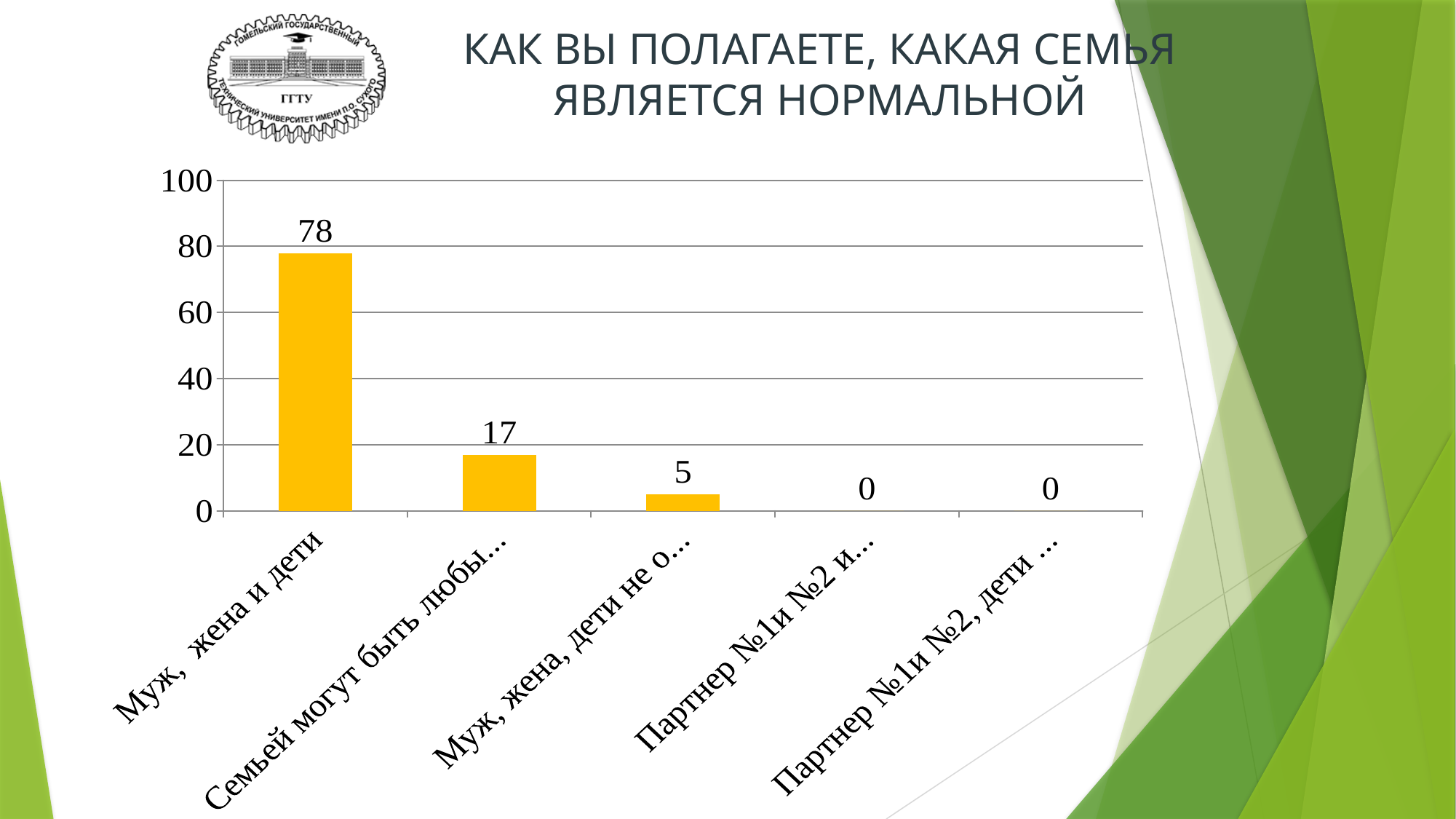
What value is shown for the category "Муж, жена и дети"? 78 What value is shown for the second bar from the left (the category beginning "Семьей могут быть любы...")? 17 What is the difference between the value for "Муж, жена и дети" and the value for the second bar from the left? 61 Which is larger: the value for "Муж, жена и дети" or the value for the third bar from the left? Муж, жена и дети What kind of chart is shown on the slide? bar chart What value is shown for the fourth category from the left (beginning "Партнер №1и №2 и...")? 0 Is the value for "Муж, жена и дети" greater or less than 60? greater What is the difference between the second bar (17) and the third bar (5)? 12 What value is shown for the third bar from the left (the category beginning "Муж, жена, дети не о...")? 5 Do the values rise or fall from left to right along the x axis? fall Which category has the highest value? Муж, жена и дети How many categories are shown on the x axis of the chart? 5